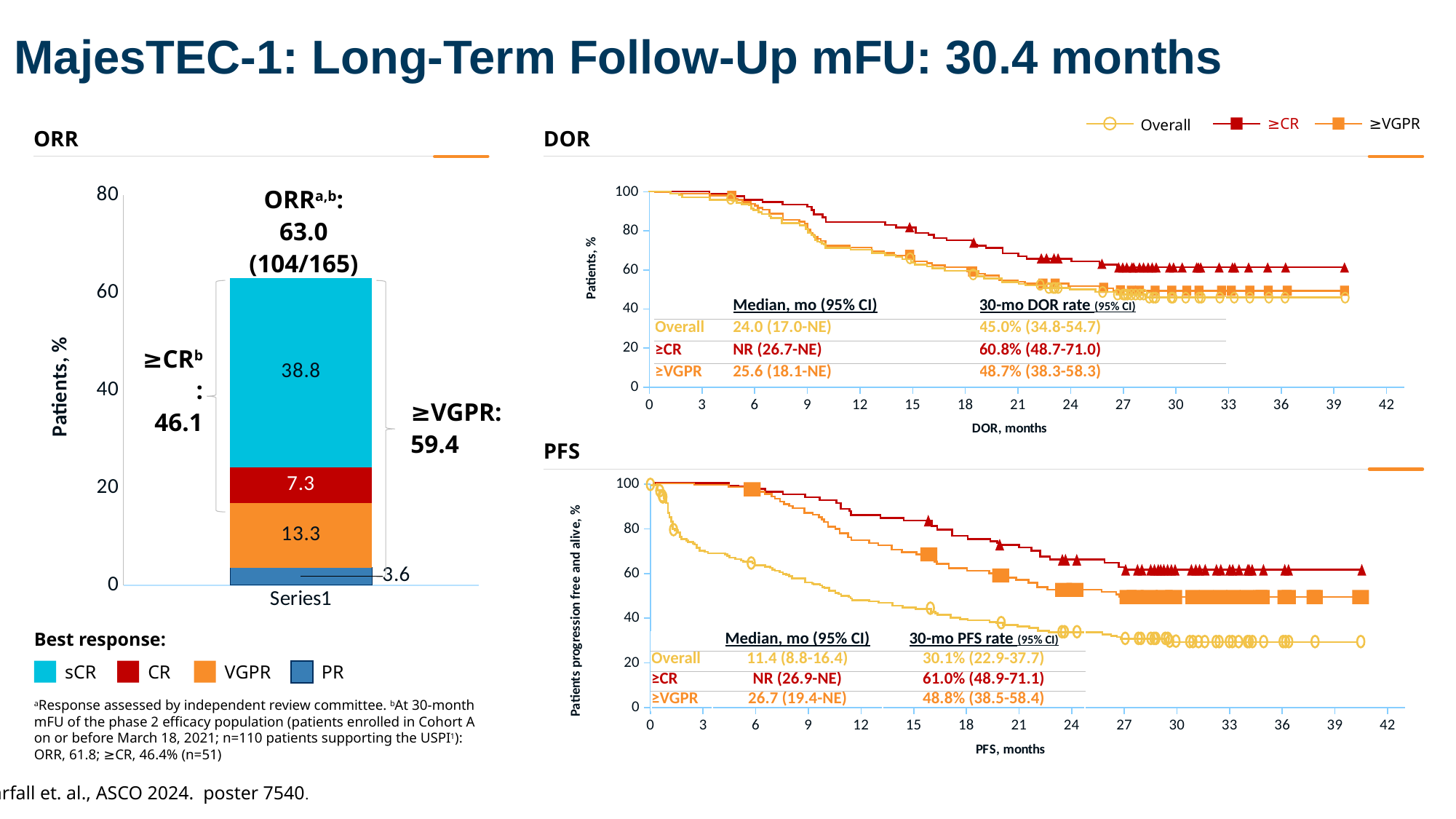
In the ORR chart, what is the difference between the sCR and CR values? 31.5 In the PFS chart, what is the median PFS in months for the Overall group? 11.4 (8.8-16.4) In the ORR chart, what is the value for PR? 3.6 In the PFS chart, which group has the lowest 30-month PFS rate? Overall In the DOR chart, what is the 30-month DOR rate for the ≥CR group? 60.8% (48.7-71.0) In the ORR chart, what is the value for VGPR? 13.3 In the ORR chart, which best response category has the largest segment? sCR In the ORR chart, what is the total of the stacked bar (the ORR)? 63.0 What kind of chart is the ORR chart? Stacked bar chart In the ORR chart, how many best response categories does the legend list? 4 In the ORR chart, which best response category has the smallest segment? PR In the ORR chart, what is the value for sCR? 38.8